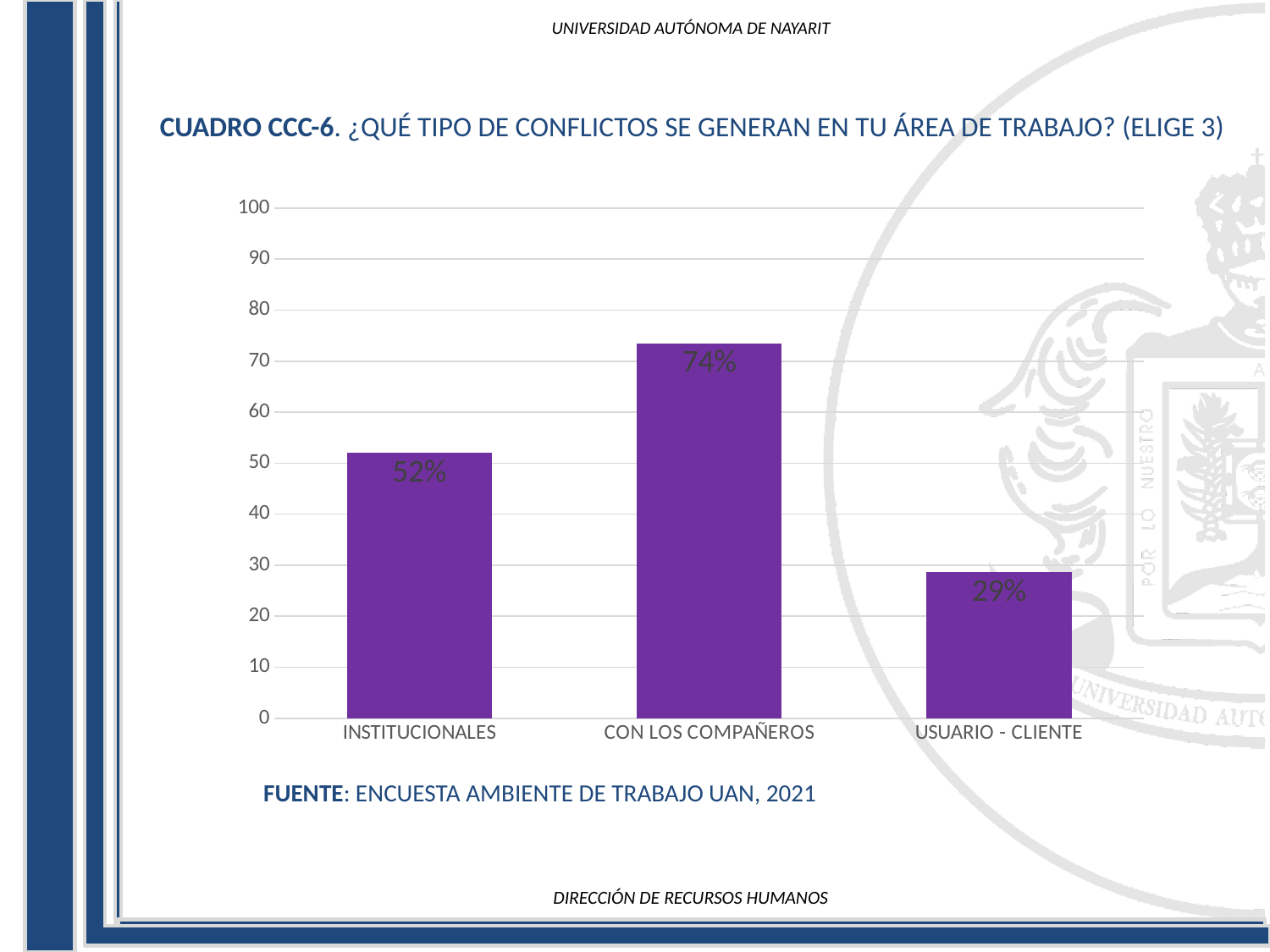
What is the value for USUARIO - CLIENTE? 29% Which is larger, the value for INSTITUCIONALES or the value for USUARIO - CLIENTE? INSTITUCIONALES What is the value for INSTITUCIONALES? 52% What is the difference between the values for INSTITUCIONALES and USUARIO - CLIENTE? 23% What kind of chart is shown on the slide? bar chart Which category has the lowest value? USUARIO - CLIENTE Is the value for CON LOS COMPAÑEROS greater or less than 60? greater Which category has the highest value? CON LOS COMPAÑEROS What source is cited below the chart? ENCUESTA AMBIENTE DE TRABAJO UAN, 2021 How many categories are shown in the chart? 3 What is the difference between the values for CON LOS COMPAÑEROS and INSTITUCIONALES? 22% What is the value for CON LOS COMPAÑEROS? 74%